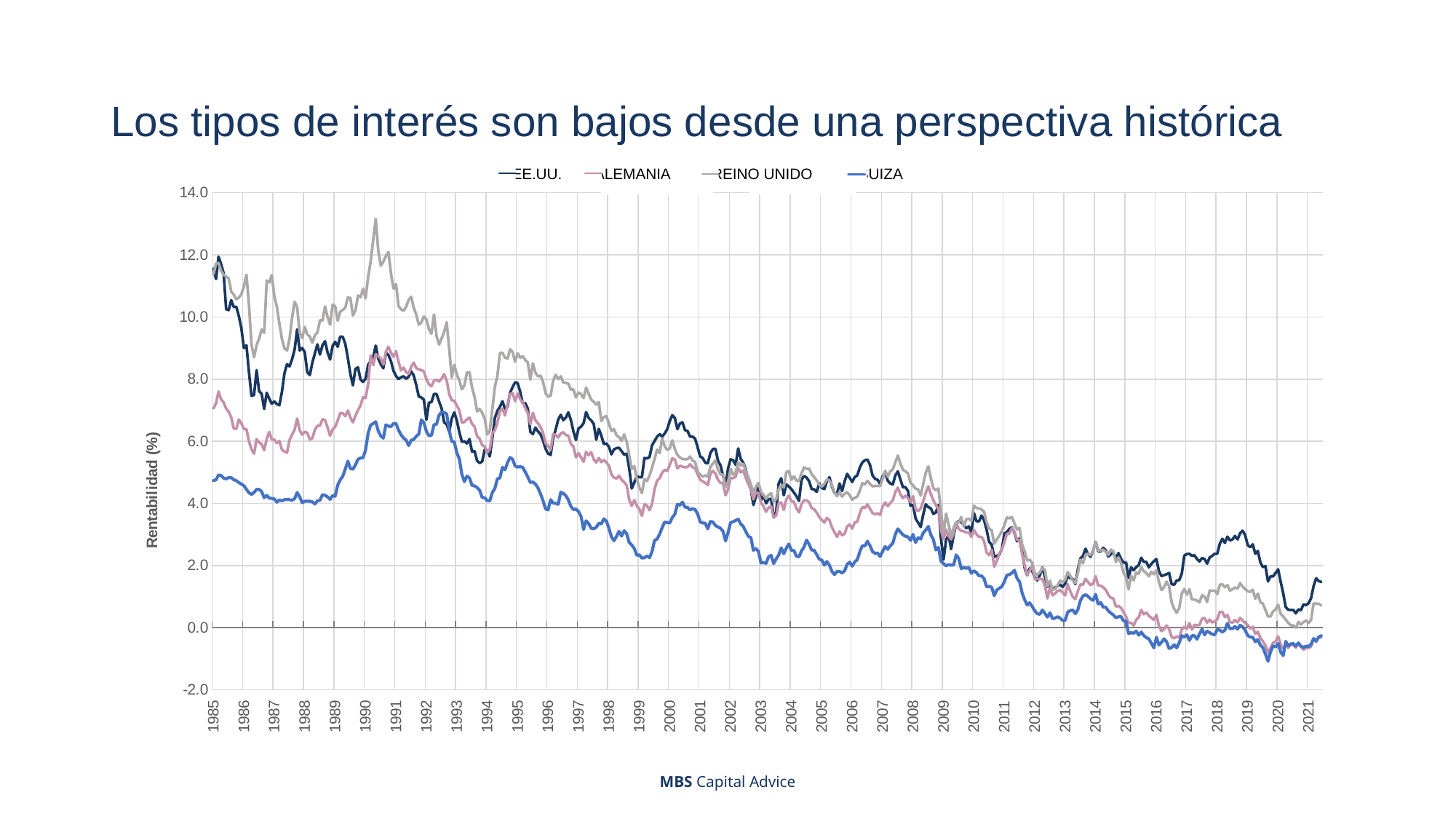
How many series does the legend list? 4 Is the value for SUIZA in 2020 greater or less than 0.0? less Is the value for SUIZA in 1985 greater or less than 6.0? less Which series does the legend list last? SUIZA Is the peak value for REINO UNIDO around 1990 greater or less than 12.0? greater Which series has the highest value at the start of 1985, EE.UU. or SUIZA? EE.UU. What kind of chart is shown on the slide? line chart What is the label of the vertical axis? Rentabilidad (%) Overall, do the values for EE.UU. rise or fall from 1985 to 2021? fall